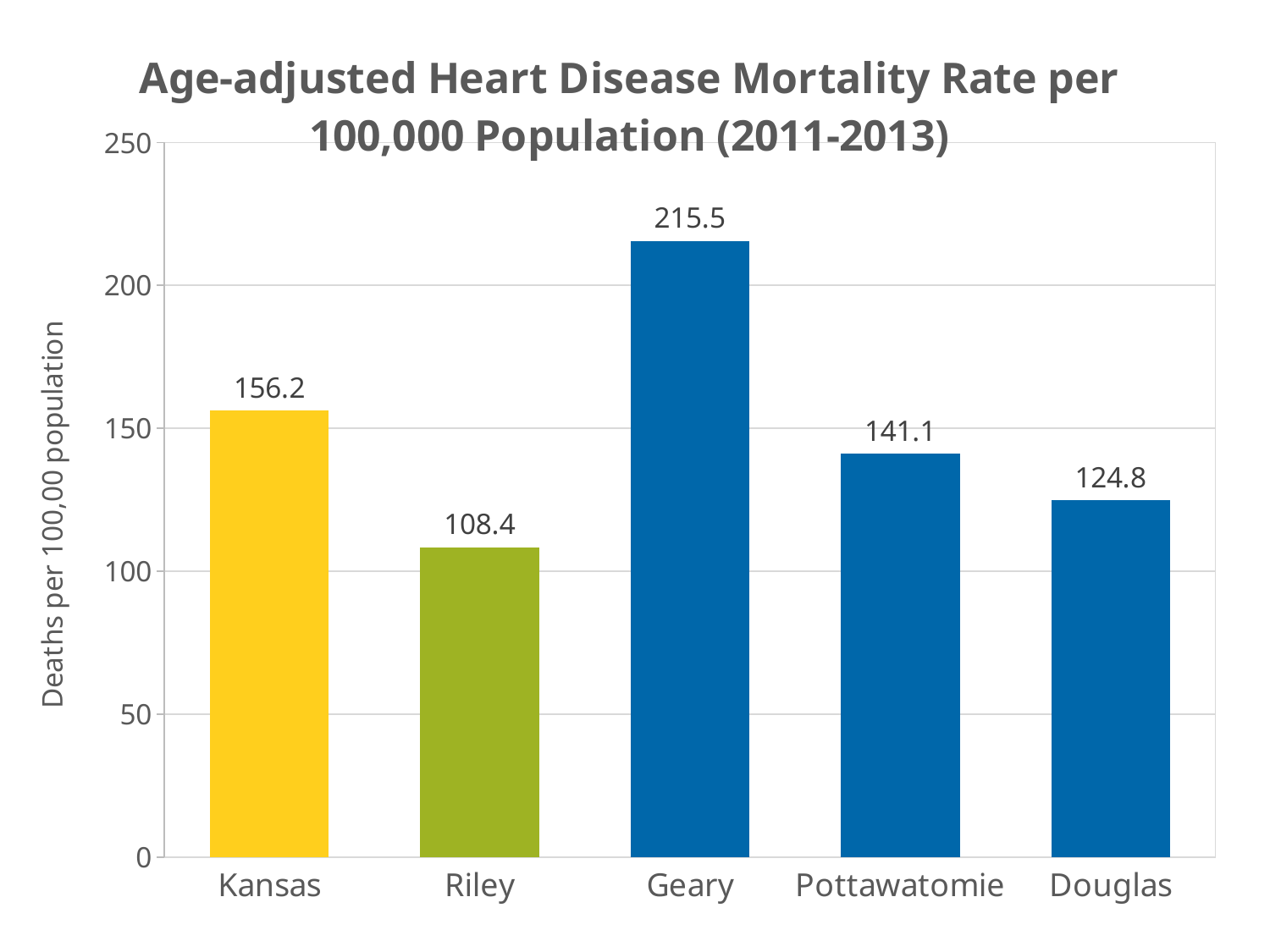
What is the difference between the mortality rates for Geary and Kansas? 59.3 How many categories are shown on the x axis? 5 What is the difference between the mortality rates for Pottawatomie and Douglas? 16.3 Which category has the lowest heart disease mortality rate? Riley Which category has the highest heart disease mortality rate? Geary What is the age-adjusted heart disease mortality rate for Riley? 108.4 Which has a higher heart disease mortality rate, Kansas or Douglas? Kansas What is the label of the vertical axis? Deaths per 100,00 population Is the value for Geary greater or less than 200? greater What kind of chart is shown on the slide? Bar chart What is the age-adjusted heart disease mortality rate for Kansas? 156.2 What is the age-adjusted heart disease mortality rate for Pottawatomie? 141.1